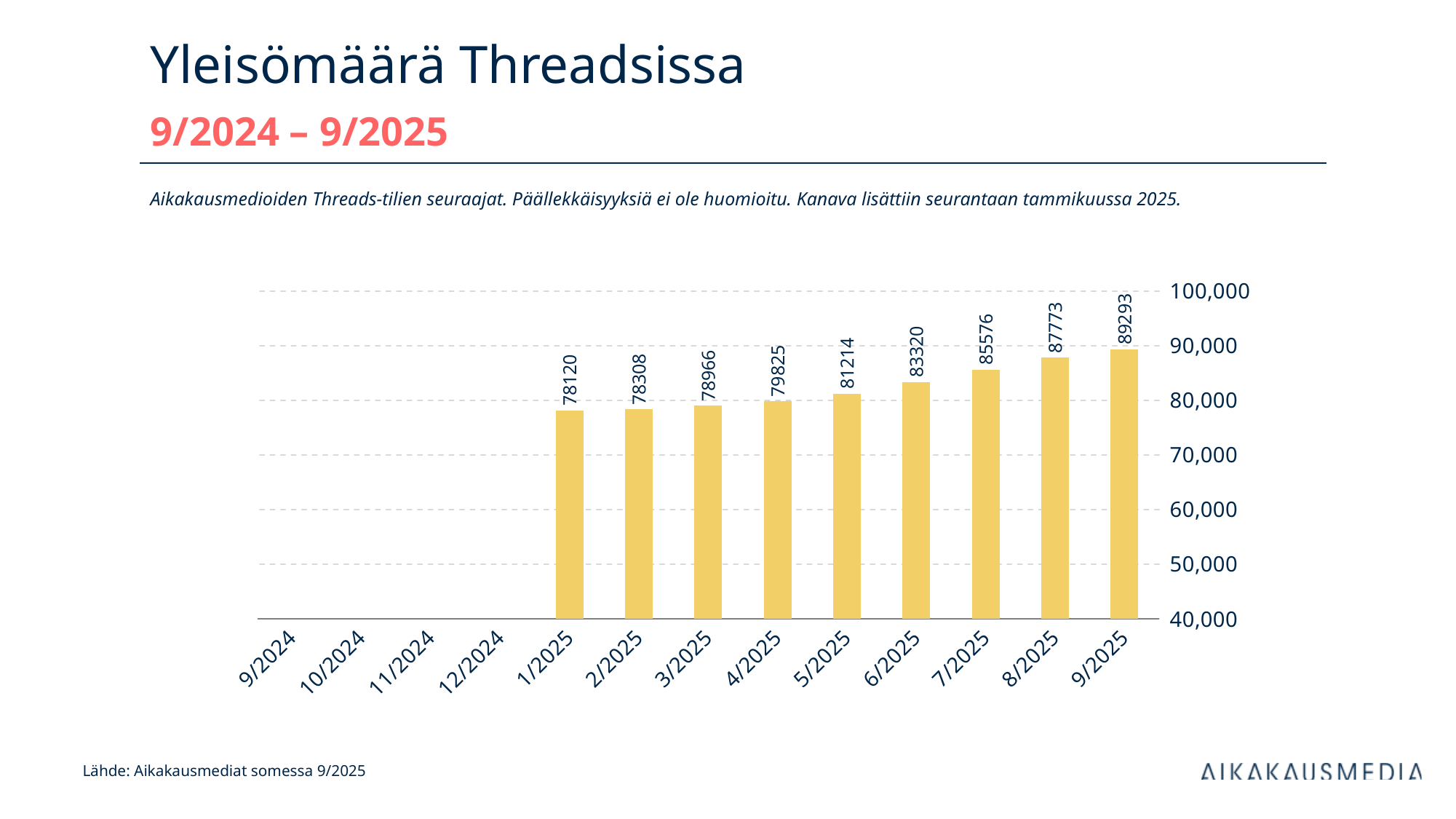
What is the value for 5/2025? 81214 Which is larger, the value for 6/2025 or the value for 4/2025? 6/2025 Is the value for 7/2025 greater or less than 80,000? greater What kind of chart is shown? bar chart What is the difference between the values for 9/2025 and 1/2025? 11173 Do the values rise or fall from 1/2025 to 9/2025? rise What is the value for 9/2025? 89293 Which month with a plotted bar has the lowest value? 1/2025 Which month has the highest value? 9/2025 What is the value for 1/2025? 78120 What is the difference between the values for 8/2025 and 7/2025? 2197 How many months have a plotted bar? 9